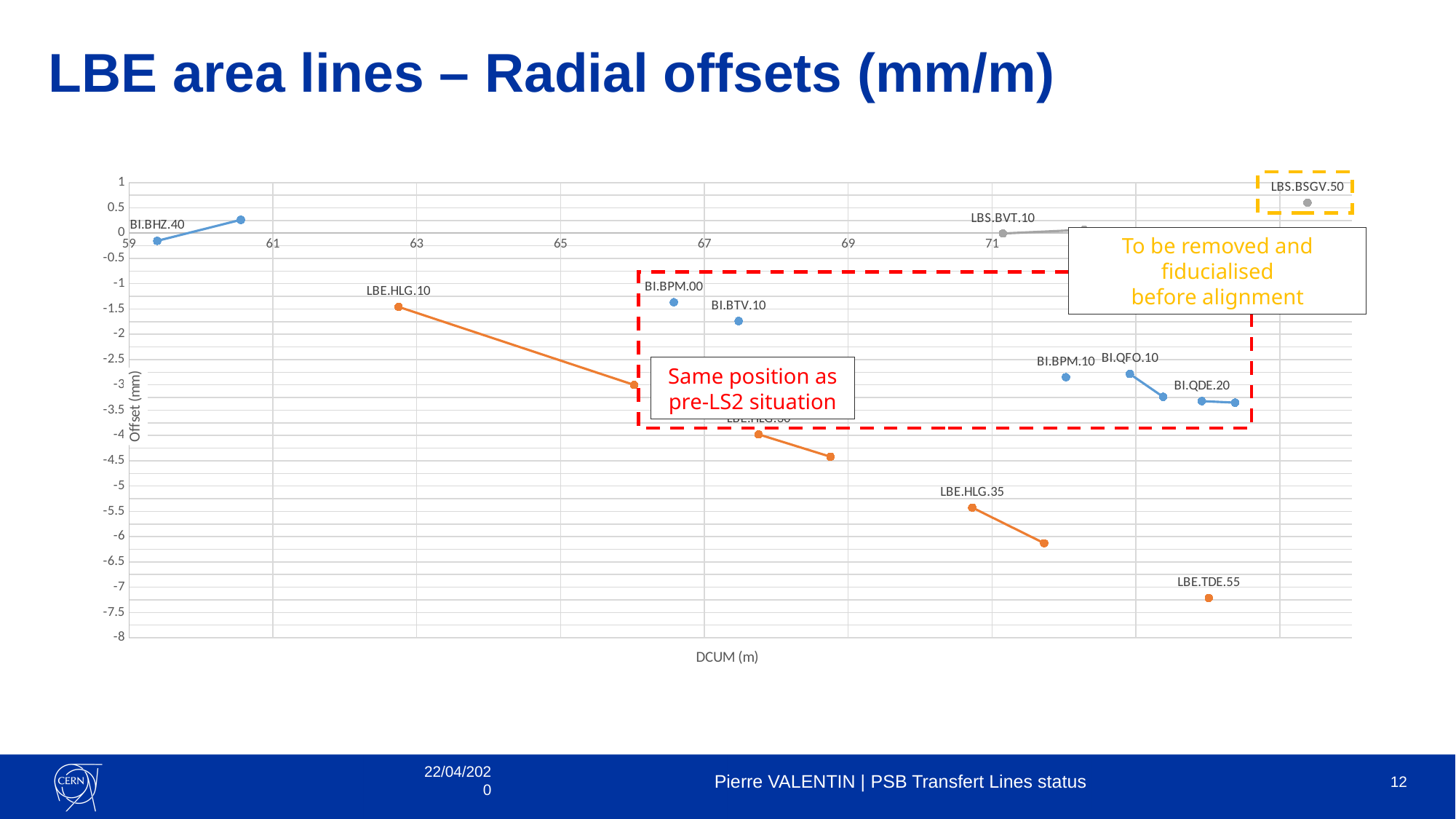
What kind of chart is shown on the slide? scatter chart Is the first point of LBE.HLG.35 greater or less than -5? less Is the offset for BI.BPM.00 greater or less than -1.5? greater Which has the higher offset, BI.BPM.00 or BI.BTV.10? BI.BPM.00 Is the offset for LBE.TDE.55 greater or less than -7? less Does the offset for LBE.HLG.10 rise or fall as DCUM increases along its line segment? fall Which labelled element has the highest offset on the chart? LBS.BSGV.50 Which labelled element has the lowest offset on the chart? LBE.TDE.55 What is the title of the y axis of the chart? Offset (mm) What is the title of the x axis of the chart? DCUM (m)